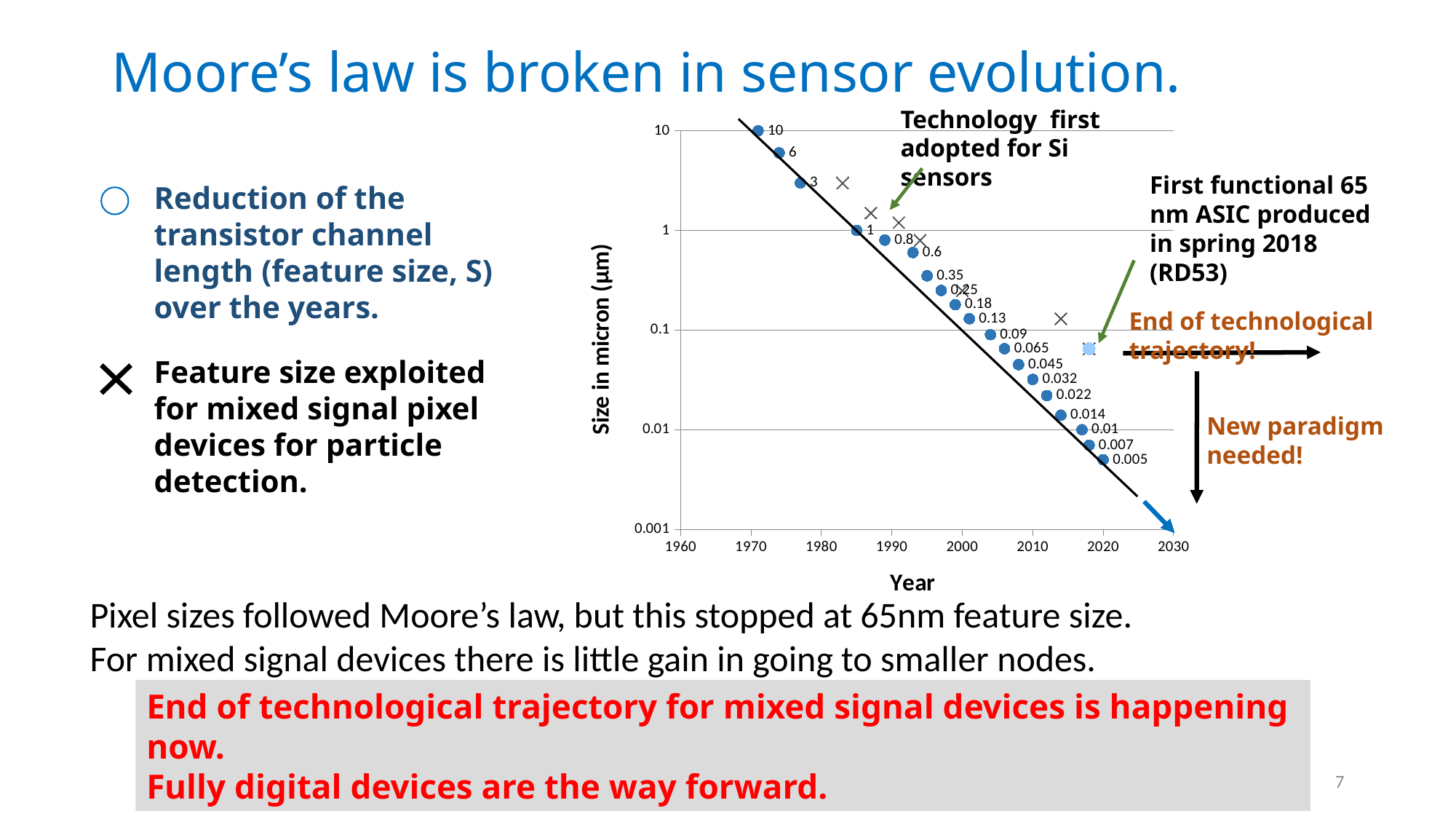
Is the value of the X marker plotted near 2014 greater or less than 0.1? greater Which labelled value is larger: 0.35 or 0.25? 0.35 What is the largest labelled value among the circle data points? 10 What is the label of the x axis of the chart? Year What is the smallest labelled value among the circle data points? 0.005 What is the difference between the two largest labelled values, 10 and 6? 4 What is the label of the y axis of the chart? Size in micron (µm) What is the labelled value of the circle point immediately after the point labelled 0.065? 0.045 How many circle data points carry a printed value label? 19 Is the value of the X marker plotted near 1983 greater or less than 1? greater Do the plotted feature-size values rise or fall as the year increases? fall What kind of chart is shown on the slide? scatter chart